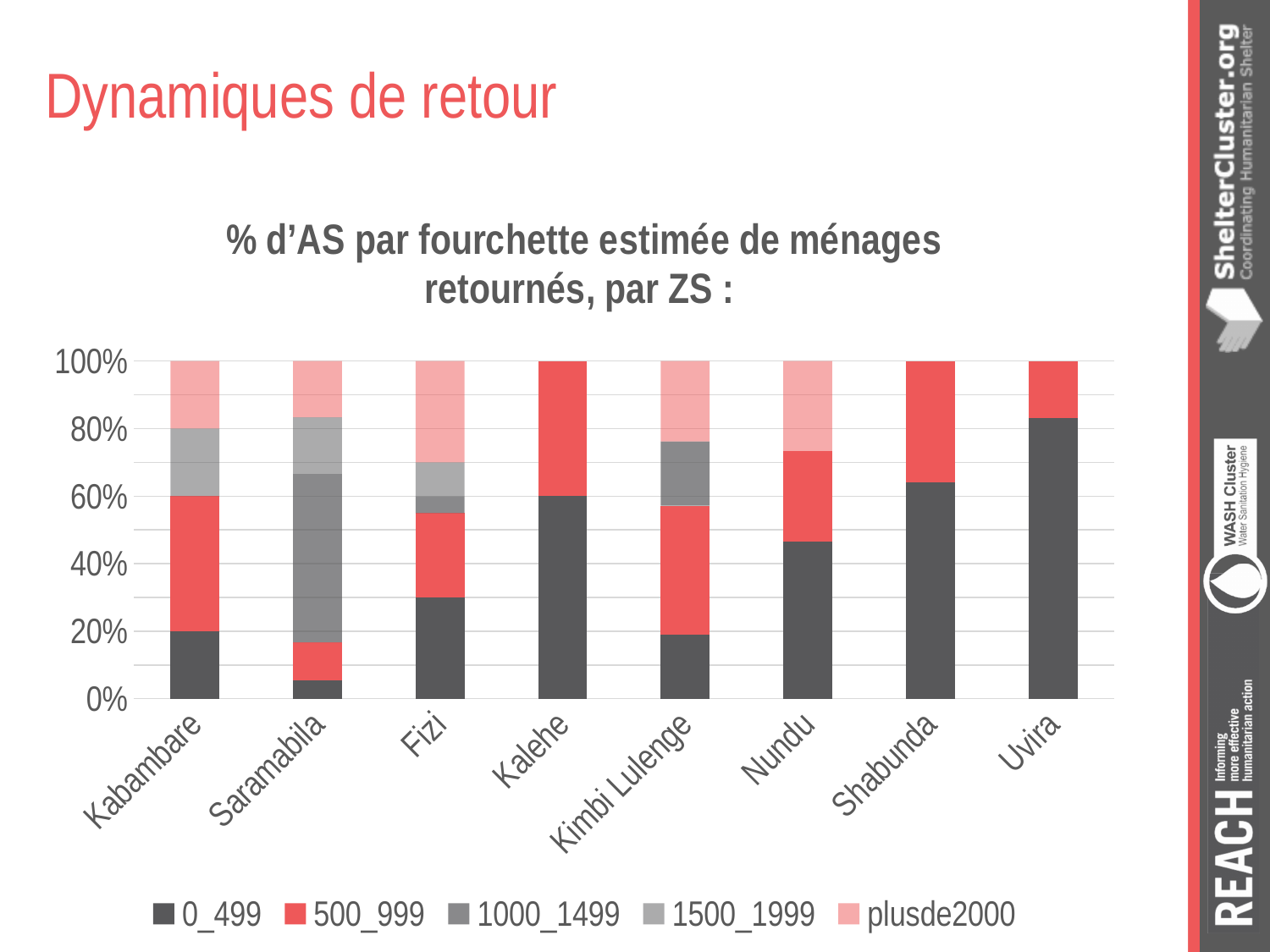
Is the 0_499 value for Nundu greater or less than 60%? less What is the title of the chart? % d'AS par fourchette estimée de ménages retournés, par ZS : How many zones de santé (categories) are shown on the x axis? 8 How many series does the legend list? 5 Which is larger, the 0_499 segment for Kalehe or for Kabambare? Kalehe Which category has the smallest 0_499 segment? Saramabila Is the 0_499 value for Uvira greater or less than 60%? greater What is the total height of the Kalehe stacked bar? 100% What kind of chart is shown on the slide? Stacked bar chart Is the 0_499 value for Saramabila greater or less than 20%? less Which category has the largest 0_499 segment? Uvira Which is larger, the 0_499 segment for Uvira or for Shabunda? Uvira